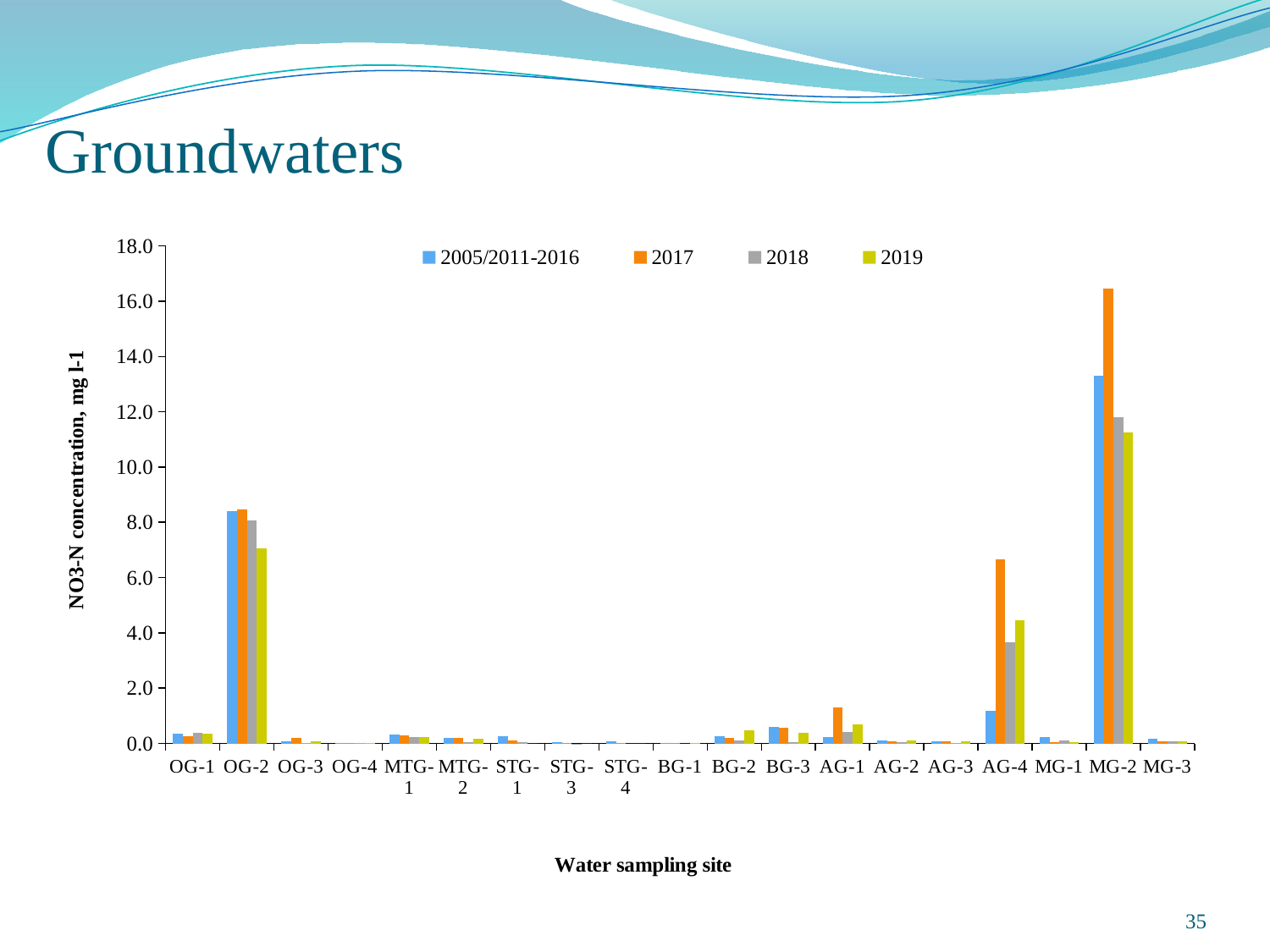
What kind of chart is shown on the slide? bar chart For the 2017 series, which is larger: the value for OG-2 or the value for AG-4? OG-2 Is the 2017 value for AG-4 greater or less than 6.0? greater Is the 2017 value for MG-2 greater or less than 14.0? greater Is the 2005/2011-2016 value for MG-2 greater or less than 12.0? greater At site MG-2, which series has the highest value? 2017 How many water sampling sites are shown on the x axis? 19 At site MG-2, which series has the lowest value? 2019 Which water sampling site has the highest NO3-N concentration? MG-2 How many series does the legend list? 4 What is the label of the y axis? NO3-N concentration, mg l-1